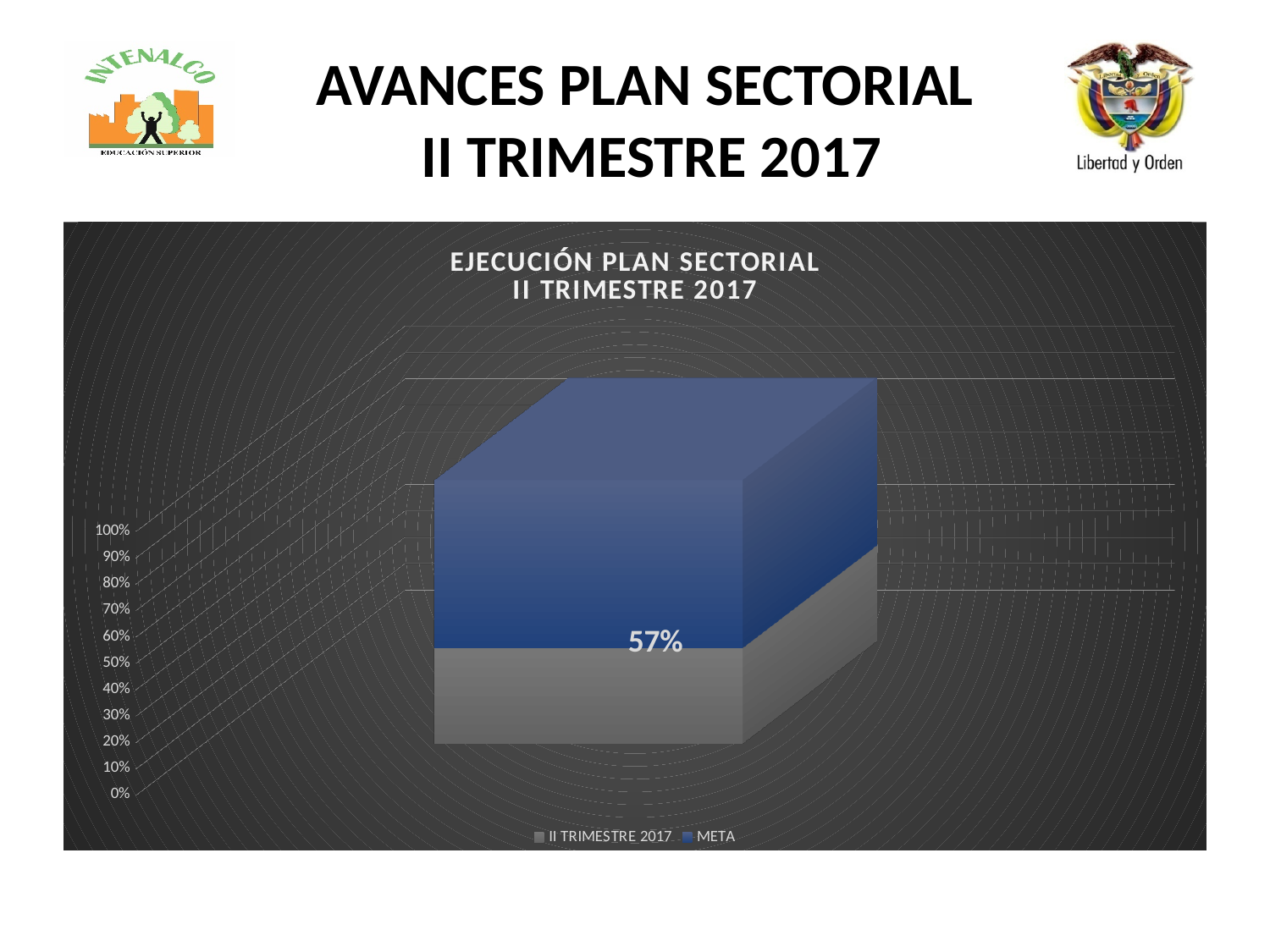
What is the title of the chart? EJECUCIÓN PLAN SECTORIAL II TRIMESTRE 2017 Is the value for II TRIMESTRE 2017 greater or less than 60%? less How many stacked bars are plotted in the chart? 1 Is the value for II TRIMESTRE 2017 greater or less than 50%? greater What kind of chart is shown on the slide? bar chart How many series does the chart legend list? 2 What is the value labelled for II TRIMESTRE 2017 in the chart? 57% Which series is shown in blue in the chart? META